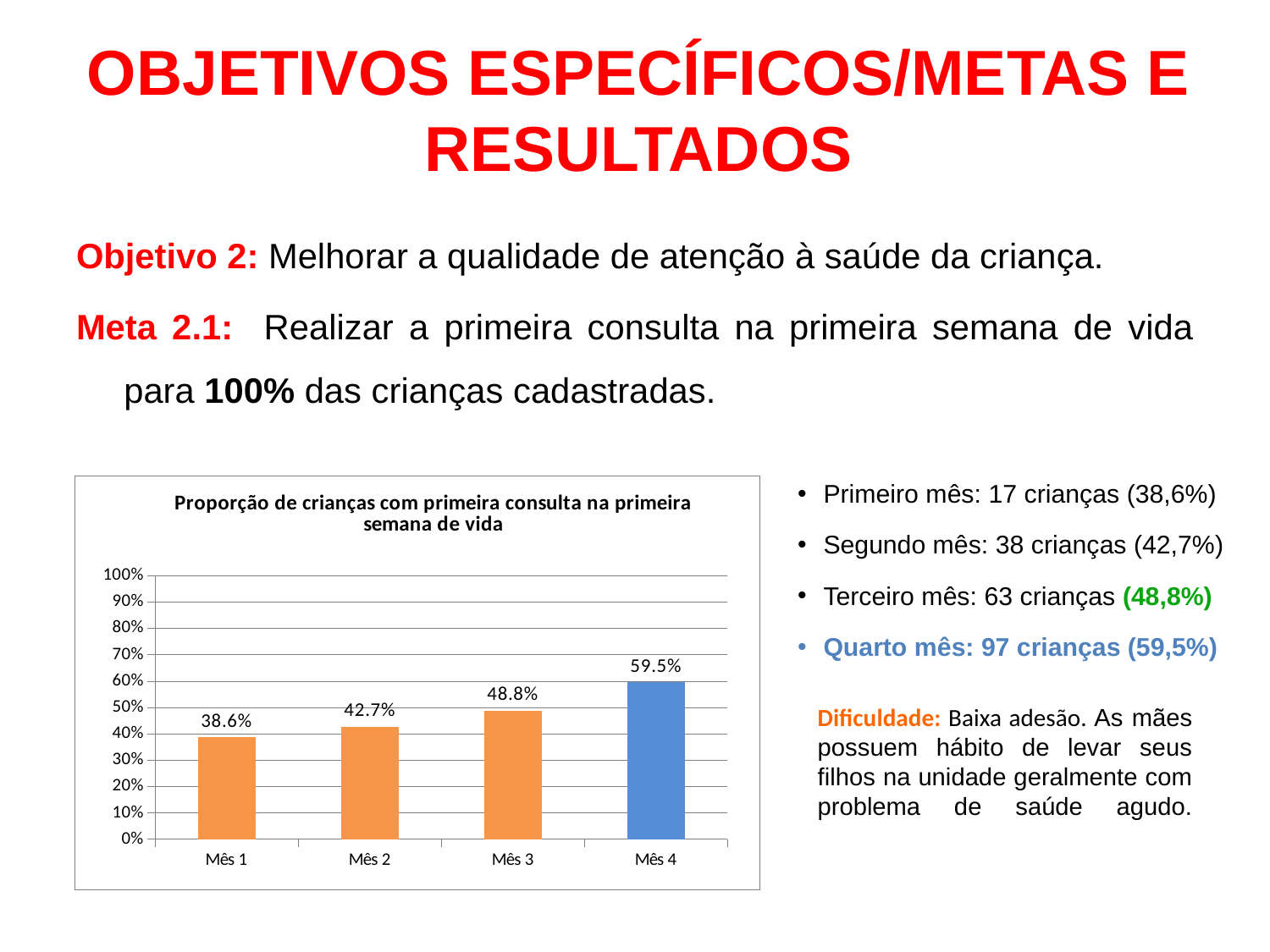
Which month has the highest value? Mês 4 What is the value for Mês 4? 59.5% How many months are shown on the x axis? 4 What is the value for Mês 1? 38.6% Which is larger, the value for Mês 2 or the value for Mês 3? Mês 3 What is the difference between the values for Mês 3 and Mês 2? 6.1% Which month has the lowest value? Mês 1 What kind of chart is shown? bar chart What is the difference between the values for Mês 4 and Mês 1? 20.9% Do the values rise or fall from Mês 1 to Mês 4? rise Is the value for Mês 4 greater or less than 50%? greater What is the value for Mês 3? 48.8%